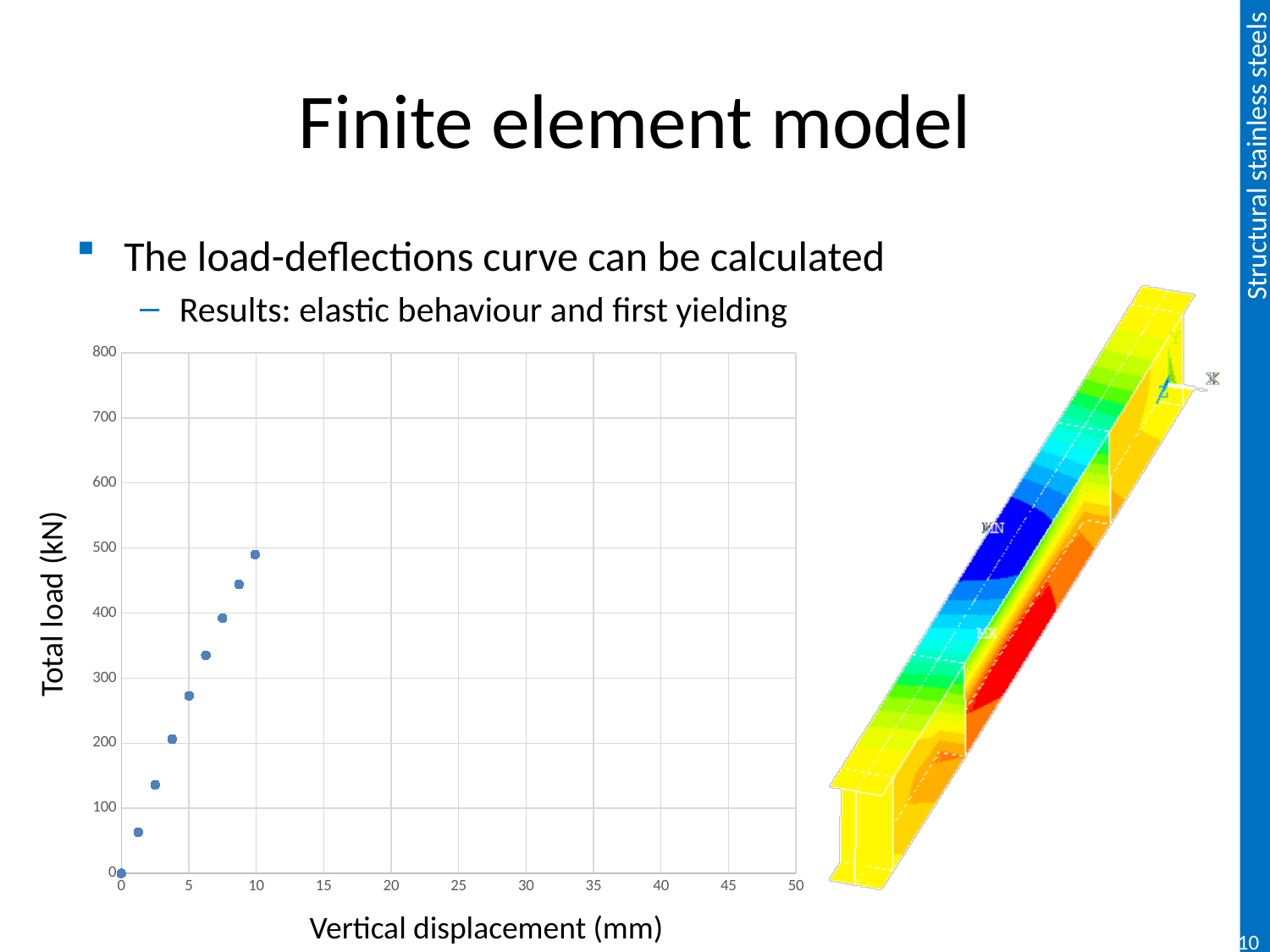
What is the label of the horizontal axis of the chart? Vertical displacement (mm) Is the total load of the point plotted at about 5 mm displacement greater or less than 200 kN? greater Is the total load of the second plotted point (just after the origin) greater or less than 100 kN? less Does the total load rise or fall as the vertical displacement increases? Rise Which has the higher total load: the point at about 10 mm displacement or the point at about 2.5 mm displacement? The point at about 10 mm displacement Are all plotted points located at a vertical displacement less than 15 mm? Yes How many data points are plotted on the chart? 9 What is the maximum value shown on the vertical axis of the chart? 800 What is the label of the vertical axis of the chart? Total load (kN) What kind of chart is shown on the slide? Scatter chart